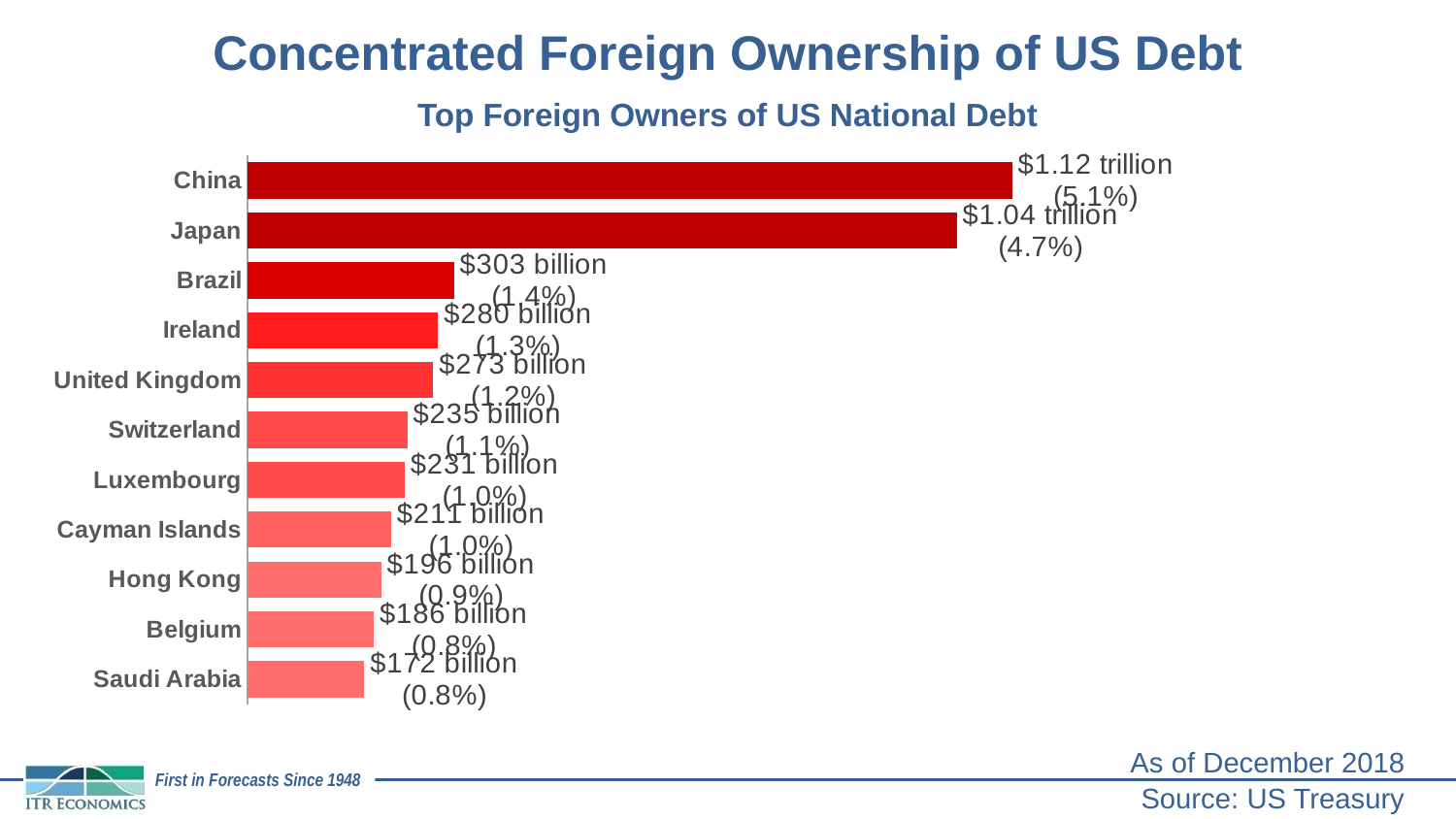
What percentage is shown in parentheses for Japan? 4.7% How many countries are shown on the chart? 11 Which has a larger value, Switzerland or Cayman Islands? Switzerland What is the title of the chart? Top Foreign Owners of US National Debt Which country has the highest value on the chart? China What is the value shown for China? $1.12 trillion Which country has the lowest value on the chart? Saudi Arabia What is the difference between the values for Hong Kong and Belgium? $10 billion What is the difference between the values for Brazil and Ireland? $23 billion What is the value shown for Saudi Arabia? $172 billion What is the value shown for Brazil? $303 billion What kind of chart is shown on the slide? Bar chart